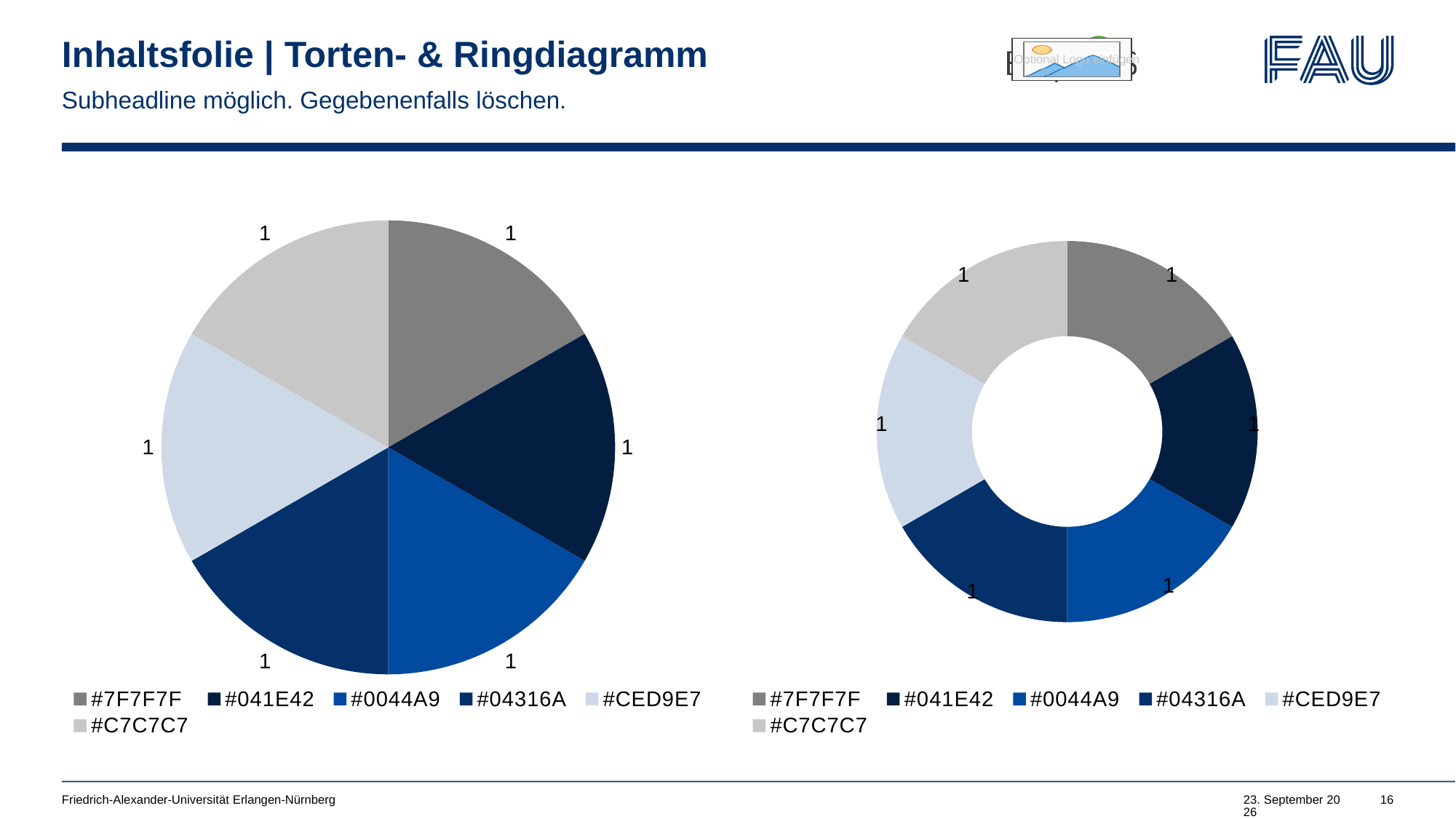
In the pie chart on the left, how many slices are there? 6 In the doughnut chart on the right, what is the value of the #CED9E7 segment? 1 What is the title of the slide containing the two charts? Inhaltsfolie | Torten- & Ringdiagramm In the pie chart on the left, what is the difference between the values of the #041E42 slice and the #C7C7C7 slice? 0 In the pie chart on the left, what is the value of the #7F7F7F slice? 1 In the pie chart on the left, what is the value of the #0044A9 slice? 1 In the doughnut chart on the right, how many segments are there? 6 In the pie chart on the left, what is the total of all slice values? 6 What kind of chart is the chart on the right of the slide? doughnut chart How many entries does the legend of the pie chart on the left list? 6 In the doughnut chart on the right, what is the total of all segment values? 6 What kind of chart is the chart on the left of the slide? pie chart